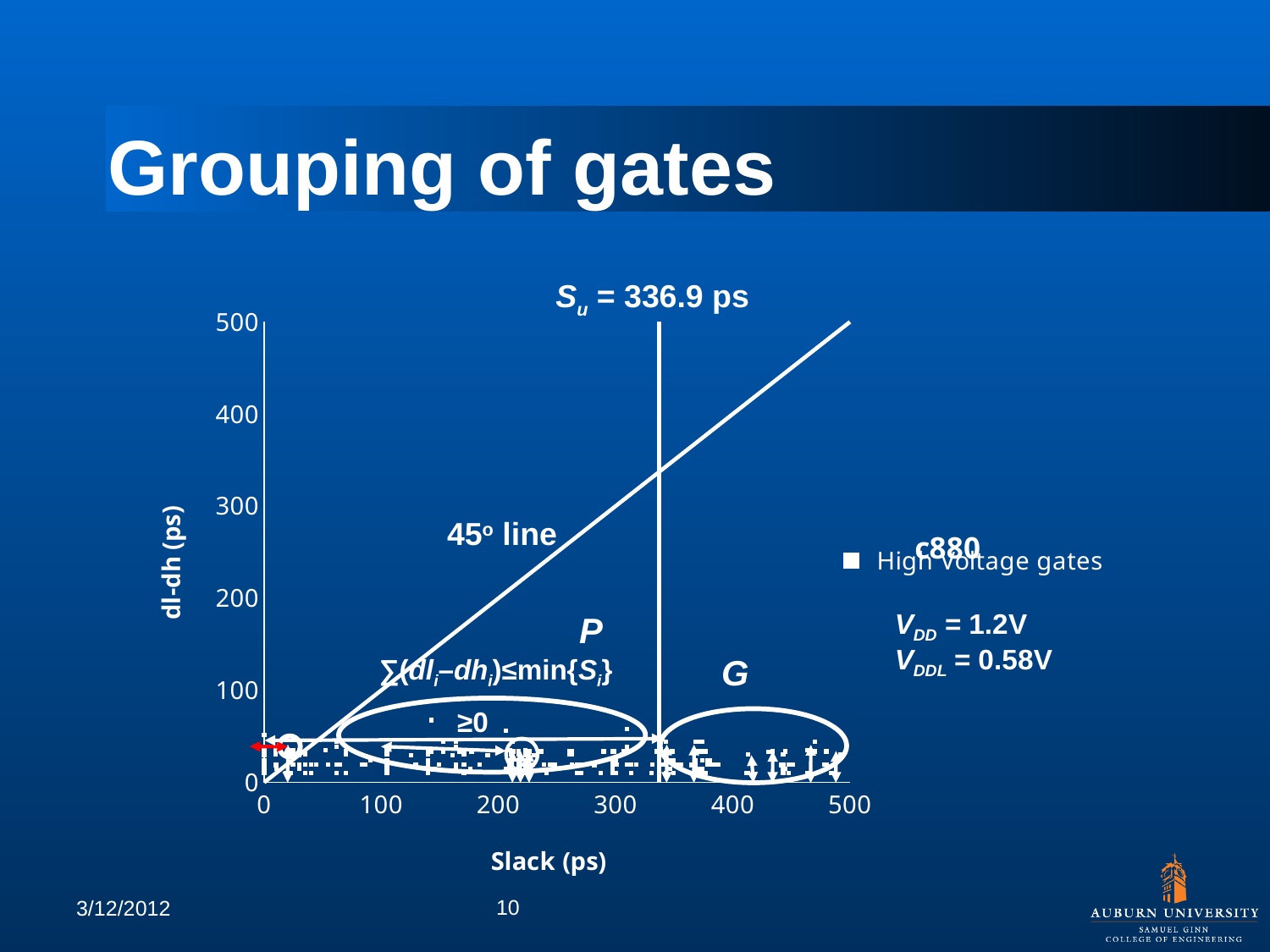
What is the maximum value shown on the x axis of the chart? 500 What kind of chart is shown on the slide? scatter chart Are the dl-dh values of the plotted points greater or less than 100 ps? less How many series does the chart legend list? 1 What series name appears in the chart legend? High Voltage gates What is the maximum value shown on the y axis of the chart? 500 What is the label of the x axis of the chart? Slack (ps) What is the value of S_u marked by the vertical line on the chart? 336.9 ps Are the dl-dh values of the plotted points greater or less than 200 ps? less